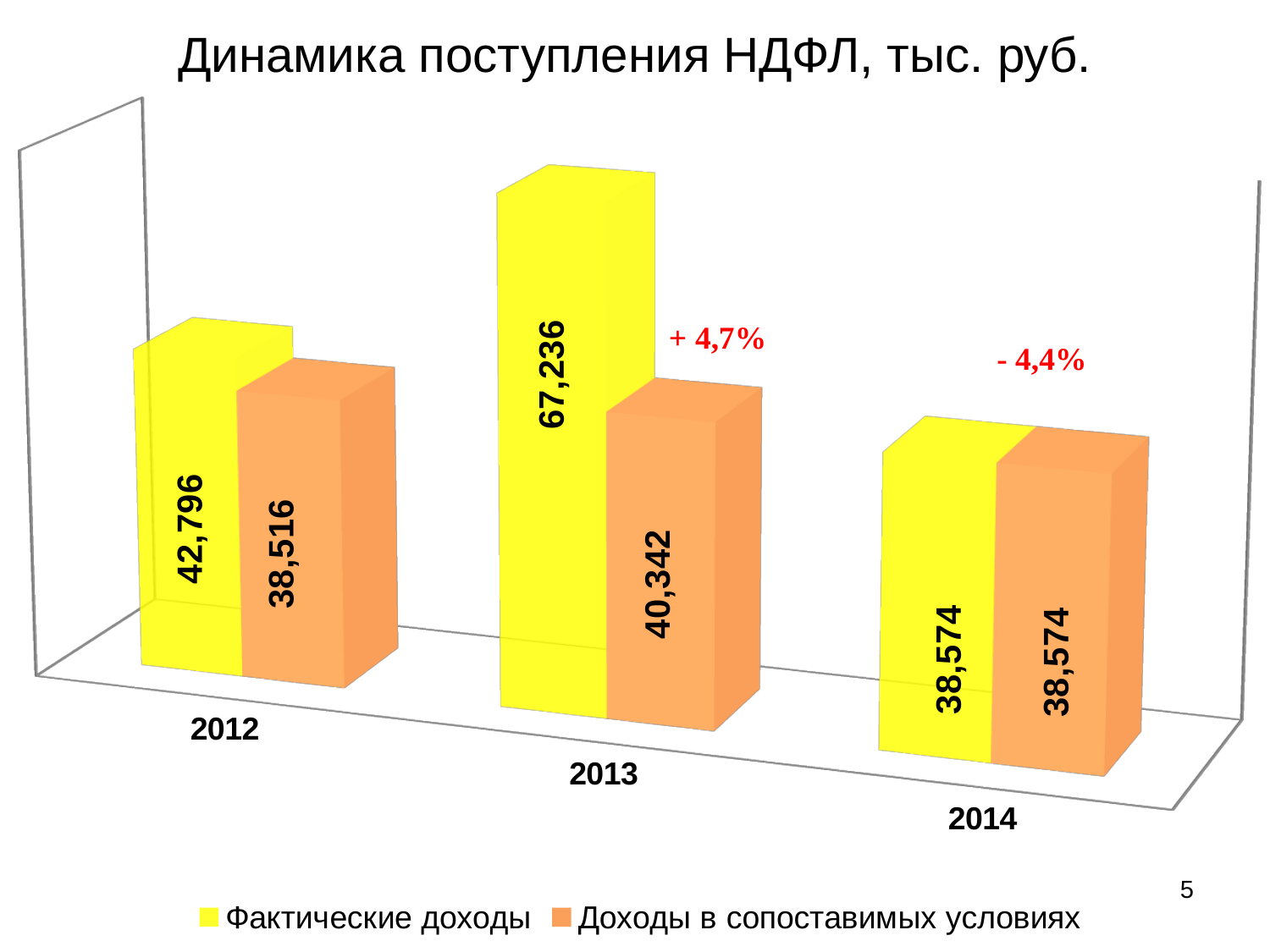
What is the difference between Фактические доходы and Доходы в сопоставимых условиях in 2012? 4,280 What kind of chart is shown on the slide? Bar chart Which is larger: Доходы в сопоставимых условиях in 2013 or in 2014? 2013 What is the value of Фактические доходы for 2014? 38,574 How many series does the legend list? 2 How many years are shown on the x axis? 3 Which year has the lowest value for Фактические доходы? 2014 What is the value of Фактические доходы for 2013? 67,236 Which year has the highest value for Доходы в сопоставимых условиях? 2013 What is the value of Доходы в сопоставимых условиях for 2012? 38,516 Which year has the highest value for Фактические доходы? 2013 What is the difference between Фактические доходы and Доходы в сопоставимых условиях in 2013? 26,894